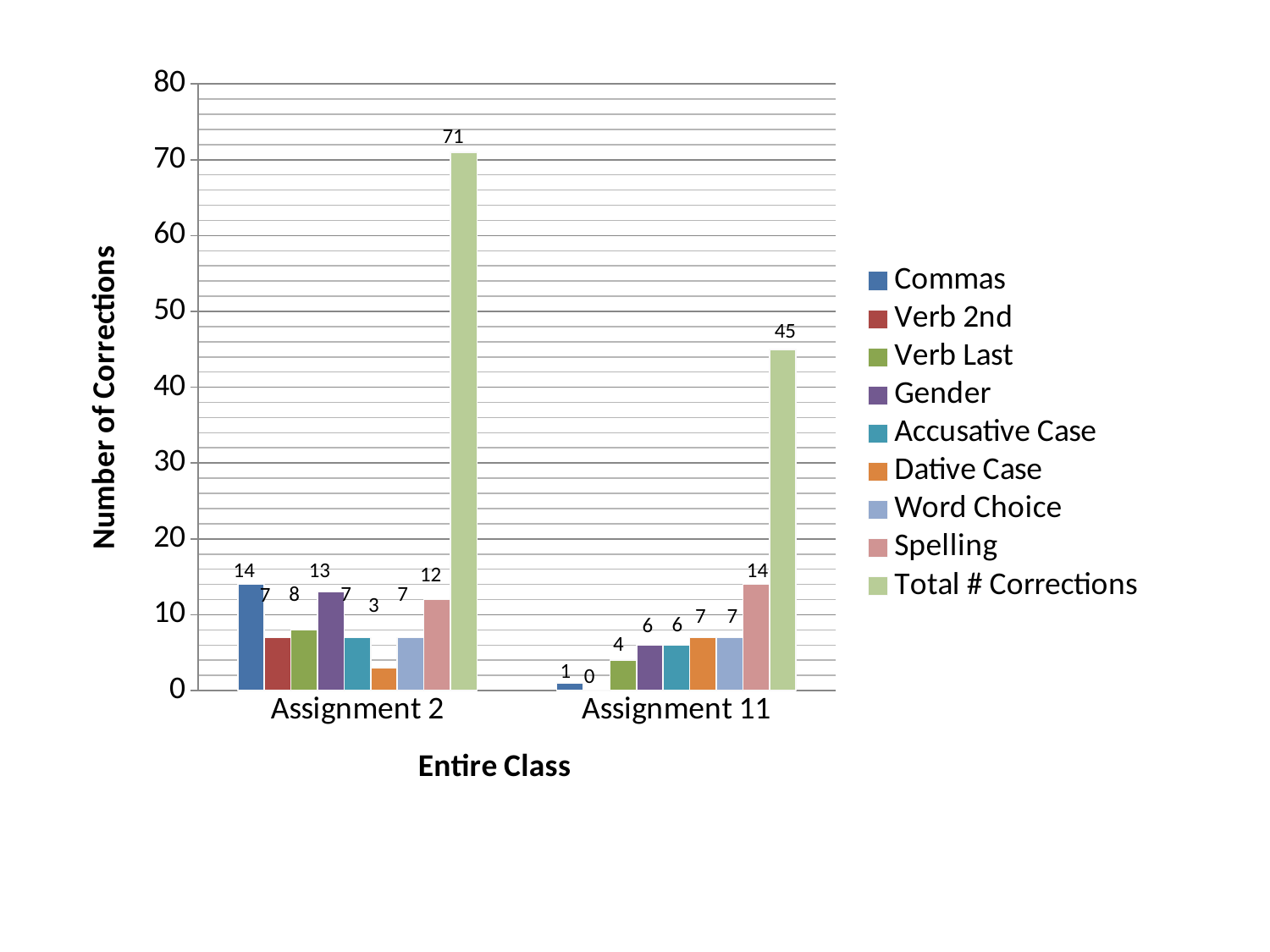
Which is larger: the Gender value for Assignment 2 or the Gender value for Assignment 11? Assignment 2 What is the label of the y axis? Number of Corrections Excluding Total # Corrections, which series has the highest value for Assignment 2? Commas How many assignment categories are shown on the x axis? 2 What is the Total # Corrections value for Assignment 2? 71 What is the Spelling value for Assignment 11? 14 Which series has the lowest value for Assignment 11? Verb 2nd What kind of chart is shown on the slide? Bar chart What is the difference between the Total # Corrections for Assignment 2 and Assignment 11? 26 How many Commas corrections are shown for Assignment 11? 1 What is the Dative Case value for Assignment 2? 3 How many series does the legend list? 9